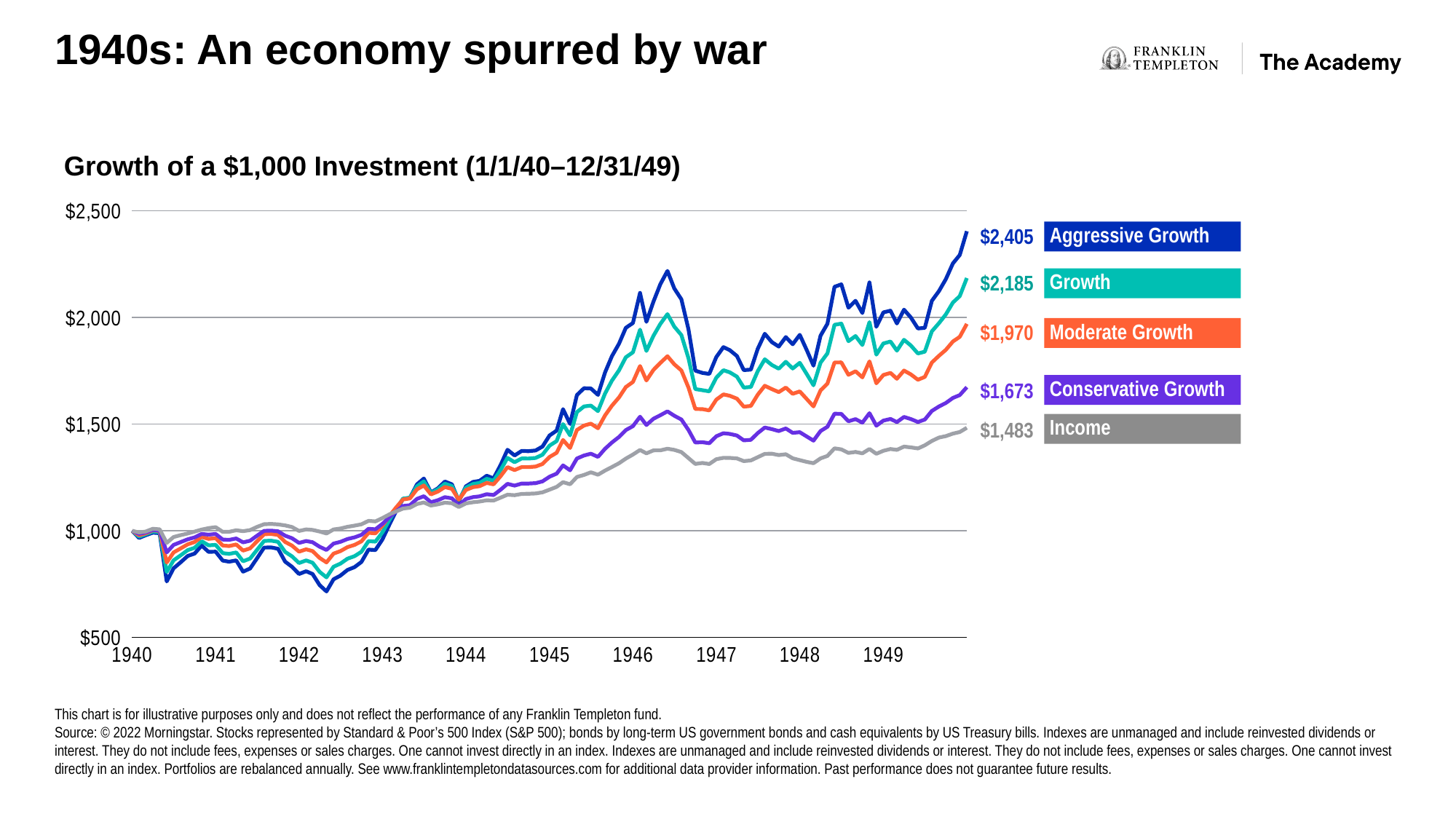
What is the difference between the ending values of the Aggressive Growth and Growth portfolios? $220 Which portfolio has the lowest ending value? Income What is the ending value of the Income portfolio? $1,483 Is the ending value of the Conservative Growth portfolio greater or less than $1,500? greater What is the ending value of the Aggressive Growth portfolio? $2,405 What kind of chart is this? Line chart What is the ending value of the Moderate Growth portfolio? $1,970 How many portfolios are shown in the legend? 5 Which portfolio has the highest ending value? Aggressive Growth What is the difference between the ending values of the Conservative Growth and Income portfolios? $190 Which has a higher ending value, Growth or Moderate Growth? Growth What is the title of the chart? Growth of a $1,000 Investment (1/1/40–12/31/49)